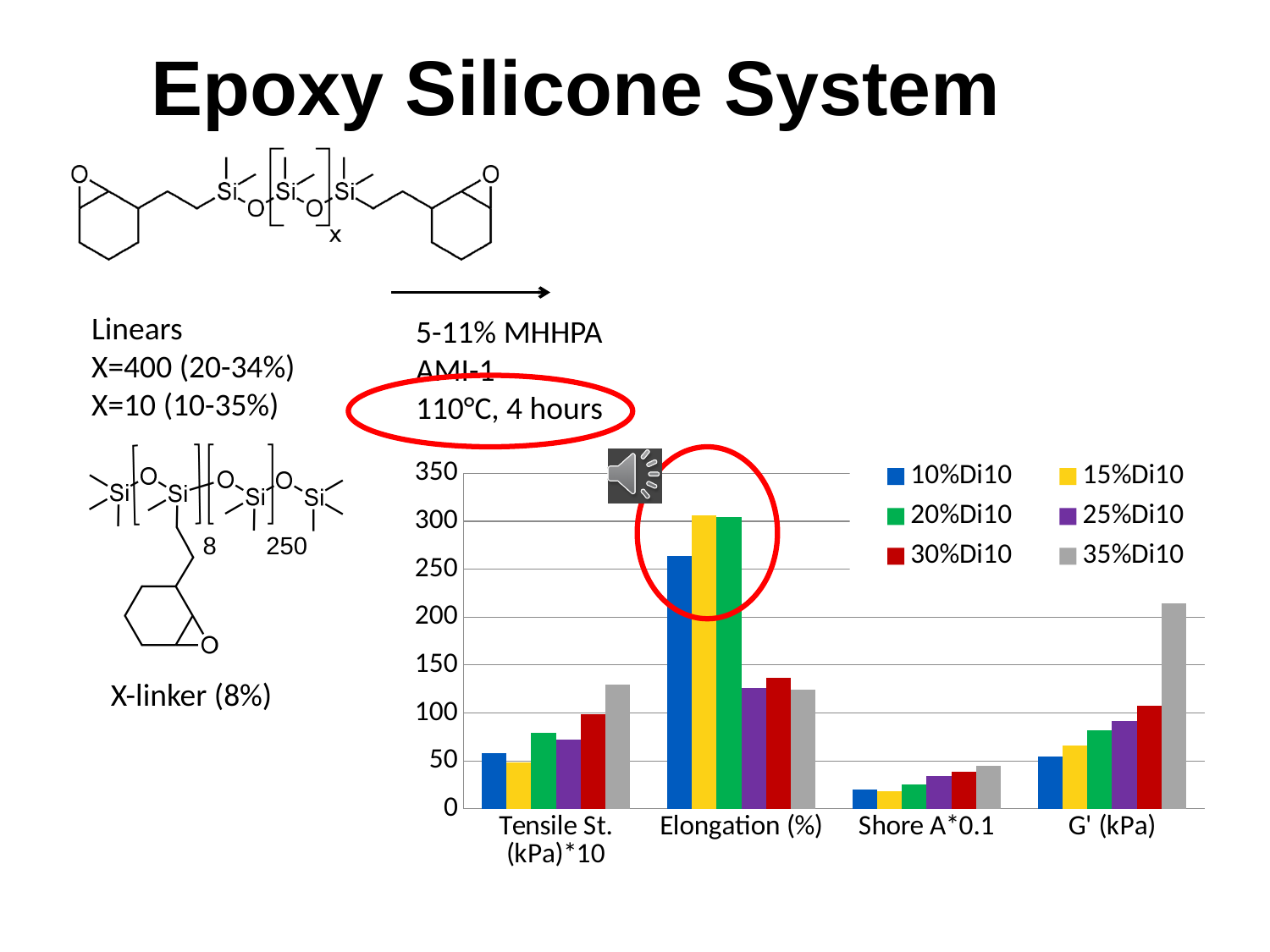
What colour represents the 35%Di10 series in the chart? grey Is the value for 30%Di10 in the Shore A*0.1 category greater or less than 50? less How many categories are shown on the x axis of the chart? 4 Is the value for 10%Di10 in the Elongation (%) category greater or less than 250? greater Which series has the highest bar in the G' (kPa) category? 35%Di10 In the G' (kPa) category, do the bars rise or fall going from 10%Di10 to 35%Di10? rise Is the value for 35%Di10 in the G' (kPa) category greater or less than 200? greater Which series has the highest bar in the Tensile St. (kPa)*10 category? 35%Di10 How many series does the chart legend list? 6 Which series has the lowest bar in the Tensile St. (kPa)*10 category? 15%Di10 Which is larger for 10%Di10: the Elongation (%) value or the G' (kPa) value? Elongation (%) What kind of chart is shown on the slide? bar chart